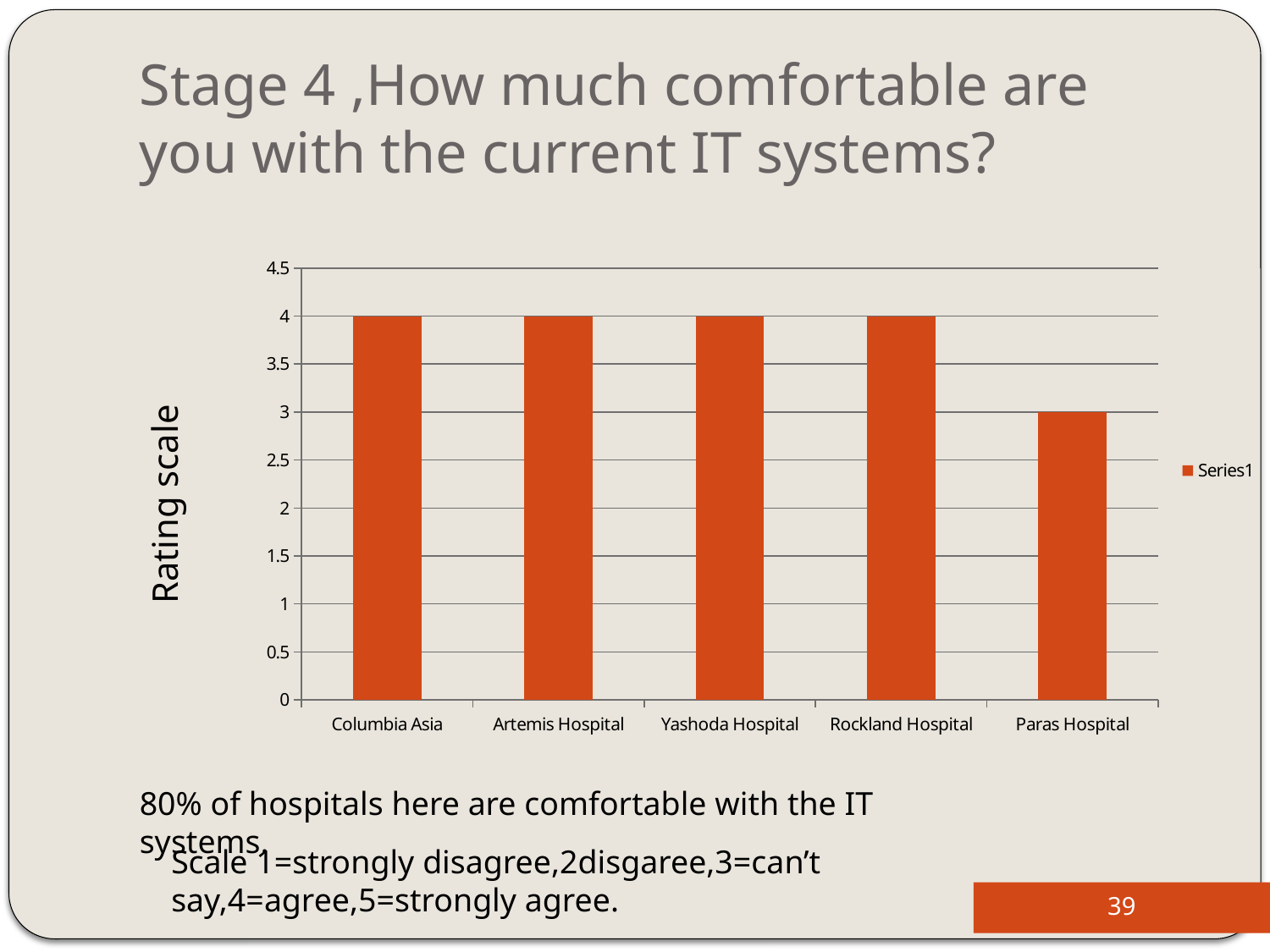
How many series does the legend list? 1 What is the value for Columbia Asia? 4 Which is larger, the value for Yashoda Hospital or the value for Paras Hospital? Yashoda Hospital What is the value for Paras Hospital? 3 What is the value for Rockland Hospital? 4 What is the difference between the values for Artemis Hospital and Paras Hospital? 1 What is the label of the vertical axis? Rating scale How many hospitals are shown on the x axis? 5 What kind of chart is shown on the slide? bar chart Is the value for Rockland Hospital greater or less than 3.5? greater Is the value for Paras Hospital greater or less than 3.5? less Which hospital has the lowest rating? Paras Hospital